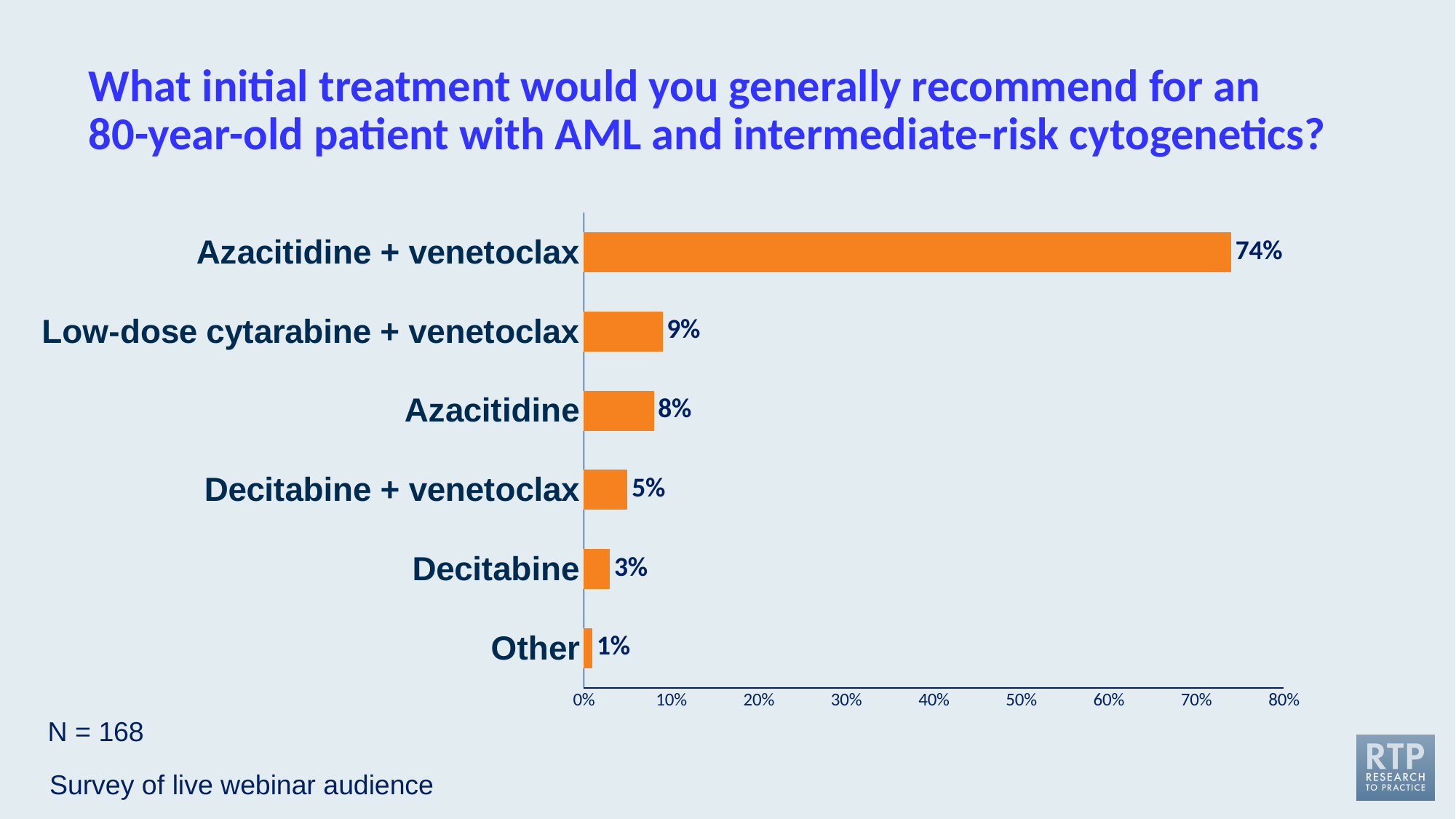
What is the difference in percentage points between Azacitidine + venetoclax and Low-dose cytarabine + venetoclax? 65 What percentage of respondents recommended Azacitidine + venetoclax? 74% What kind of chart is shown on the slide? Bar chart Is the value for Azacitidine + venetoclax greater or less than 70%? greater What percentage of respondents chose Other? 1% Which received a higher percentage: Azacitidine or Decitabine? Azacitidine What percentage of respondents recommended Decitabine + venetoclax? 5% What percentage of respondents recommended Low-dose cytarabine + venetoclax? 9% What is the sample size (N) stated on the slide? 168 Which treatment option received the highest percentage of responses? Azacitidine + venetoclax How many treatment options are shown in the chart? 6 Which option received the lowest percentage of responses? Other